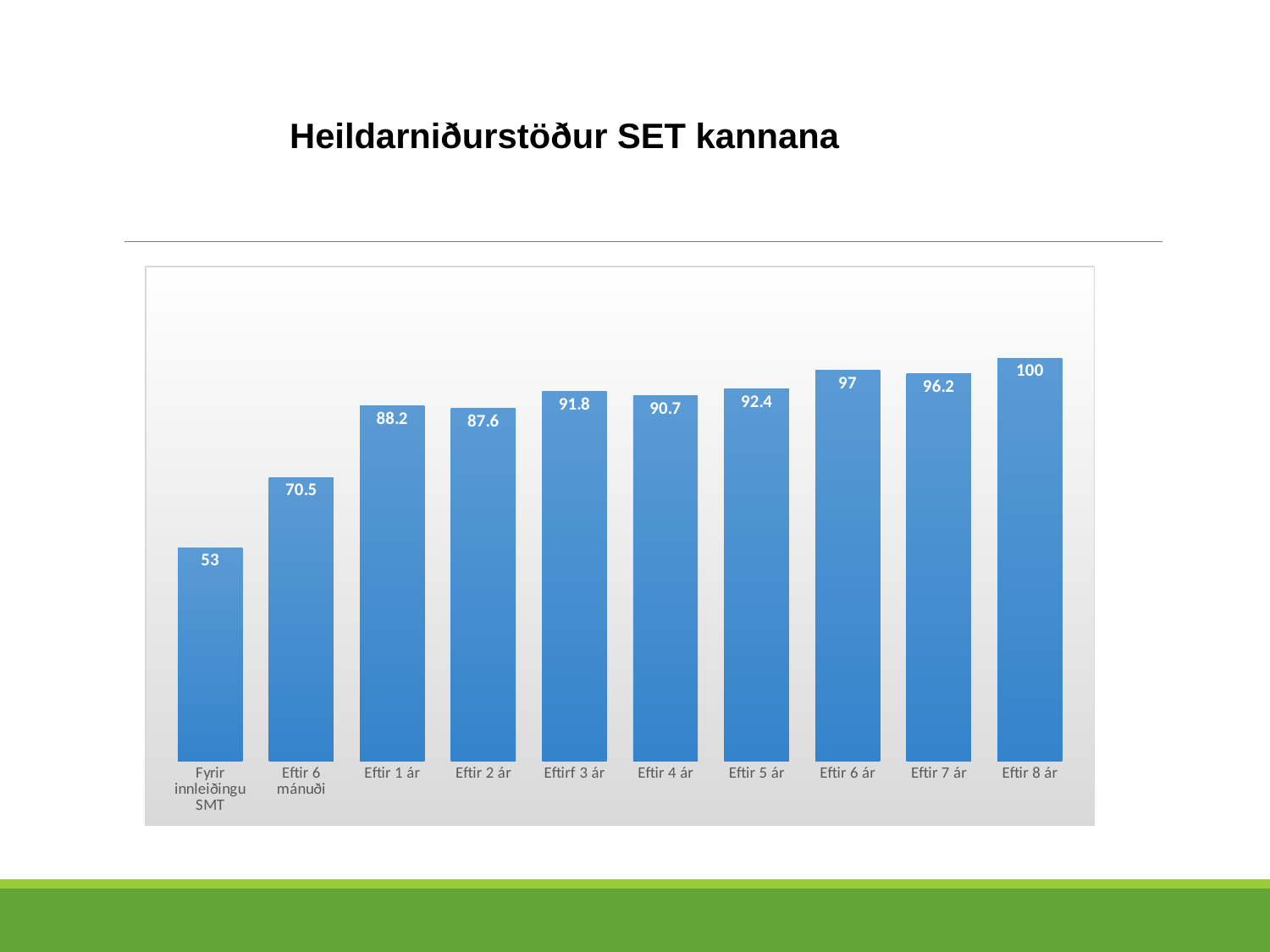
What is the value for "Eftir 5 ár"? 92.4 What is the value for "Eftir 7 ár"? 96.2 Which category has the lowest value? Fyrir innleiðingu SMT What is the value for "Eftir 6 mánuði"? 70.5 What kind of chart is shown on the slide? Bar chart What is the value for "Fyrir innleiðingu SMT"? 53 What is the difference between the values for "Eftir 8 ár" and "Fyrir innleiðingu SMT"? 47 What is the difference between the values for "Eftir 1 ár" and "Eftir 2 ár"? 0.6 How many categories are shown on the x axis? 10 What is the title of the slide? Heildarniðurstöður SET kannana Which is larger, the value for "Eftir 6 ár" or the value for "Eftir 7 ár"? Eftir 6 ár Which category has the highest value? Eftir 8 ár